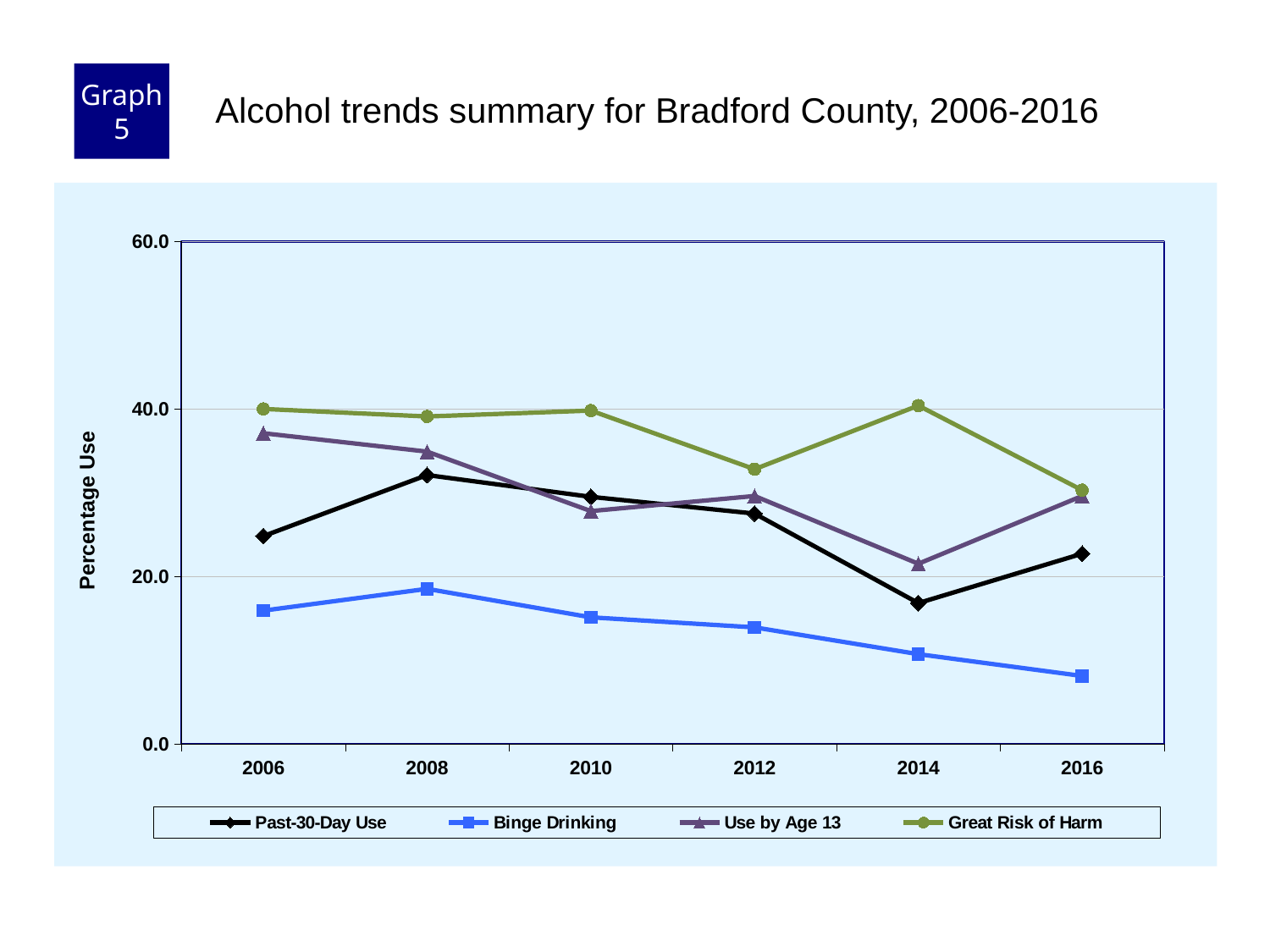
How many years are plotted along the x axis? 6 Is the value for Past-30-Day Use in 2014 greater or less than 20.0? less Is the value for Past-30-Day Use in 2008 greater or less than 20.0? greater Is the value for Great Risk of Harm in 2012 greater or less than 40.0? less How many series does the legend list? 4 What kind of chart is shown on the slide? Line chart In 2014, which is larger: Past-30-Day Use or Use by Age 13? Use by Age 13 In which year is Past-30-Day Use at its lowest? 2014 Which series has the lowest value in 2016? Binge Drinking Which series has the highest value in 2014? Great Risk of Harm Does Binge Drinking rise or fall from 2008 to 2016? Fall